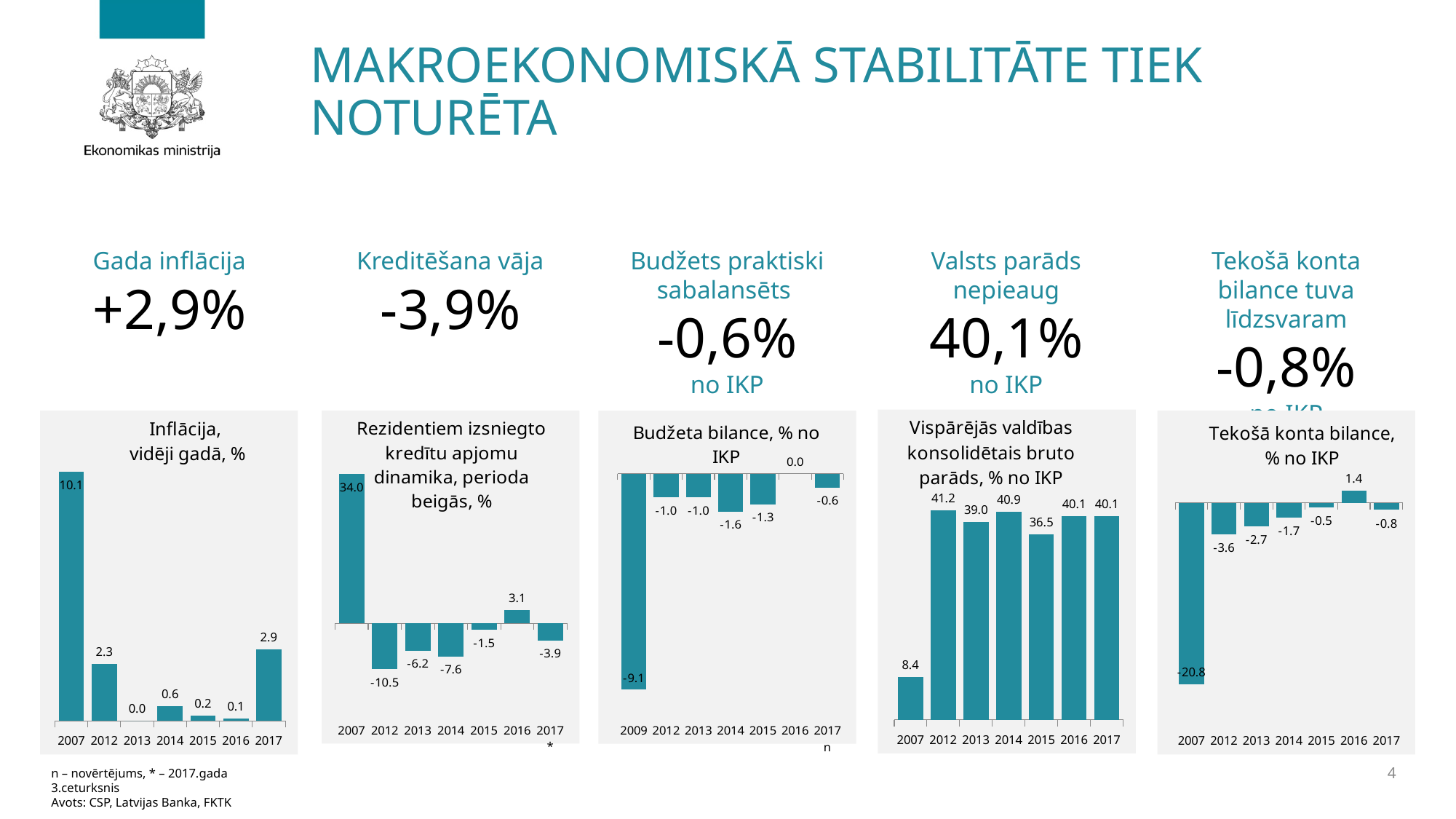
In the chart titled "Budžeta bilance, % no IKP", what is the value for 2009? -9.1 In the chart titled "Rezidentiem izsniegto kredītu apjomu dinamika, perioda beigās, %", which year has the lowest value? 2012 In the chart titled "Budžeta bilance, % no IKP", how many years are shown on the x axis? 7 What type of chart is the chart titled "Tekošā konta bilance, % no IKP"? Bar chart In the chart titled "Inflācija, vidēji gadā, %", what is the value for 2007? 10.1 In the chart titled "Vispārējās valdības konsolidētais bruto parāds, % no IKP", what is the difference between the values for 2012 and 2007? 32.8 In the chart titled "Rezidentiem izsniegto kredītu apjomu dinamika, perioda beigās, %", what is the value for 2016? 3.1 In the chart titled "Vispārējās valdības konsolidētais bruto parāds, % no IKP", which year has the highest value? 2012 In the chart titled "Tekošā konta bilance, % no IKP", what is the value for 2007? -20.8 In the chart titled "Vispārējās valdības konsolidētais bruto parāds, % no IKP", which is larger, the value for 2014 or the value for 2015? 2014 In the chart titled "Inflācija, vidēji gadā, %", which year has the lowest value? 2013 In the chart titled "Tekošā konta bilance, % no IKP", which year has the highest value? 2016